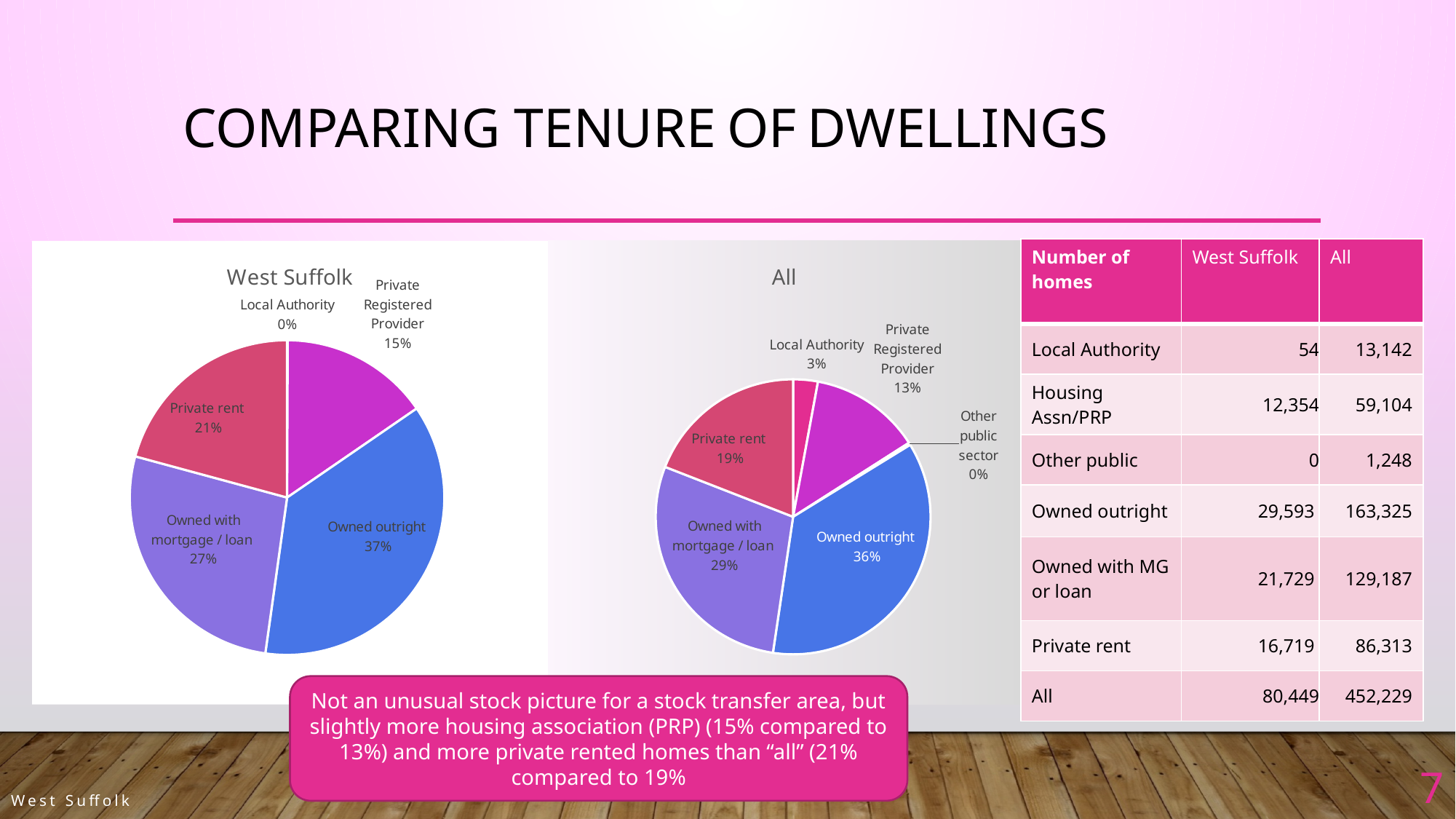
In the All pie chart, what share is Private rent? 19% What type of chart is used for the West Suffolk data? Pie chart Which is larger: the Private rent share in the West Suffolk pie chart or in the All pie chart? West Suffolk What is the difference between the Owned with mortgage / loan share in the All pie chart and in the West Suffolk pie chart? 2 percentage points In the West Suffolk pie chart, what share is Private Registered Provider? 15% In the All pie chart, what share is Local Authority? 3% In the West Suffolk pie chart, what share is Owned outright? 37% How many categories are shown in the West Suffolk pie chart? 5 In the All pie chart, which category has the largest share? Owned outright In the West Suffolk pie chart, which category has the largest share? Owned outright How many categories are shown in the All pie chart? 6